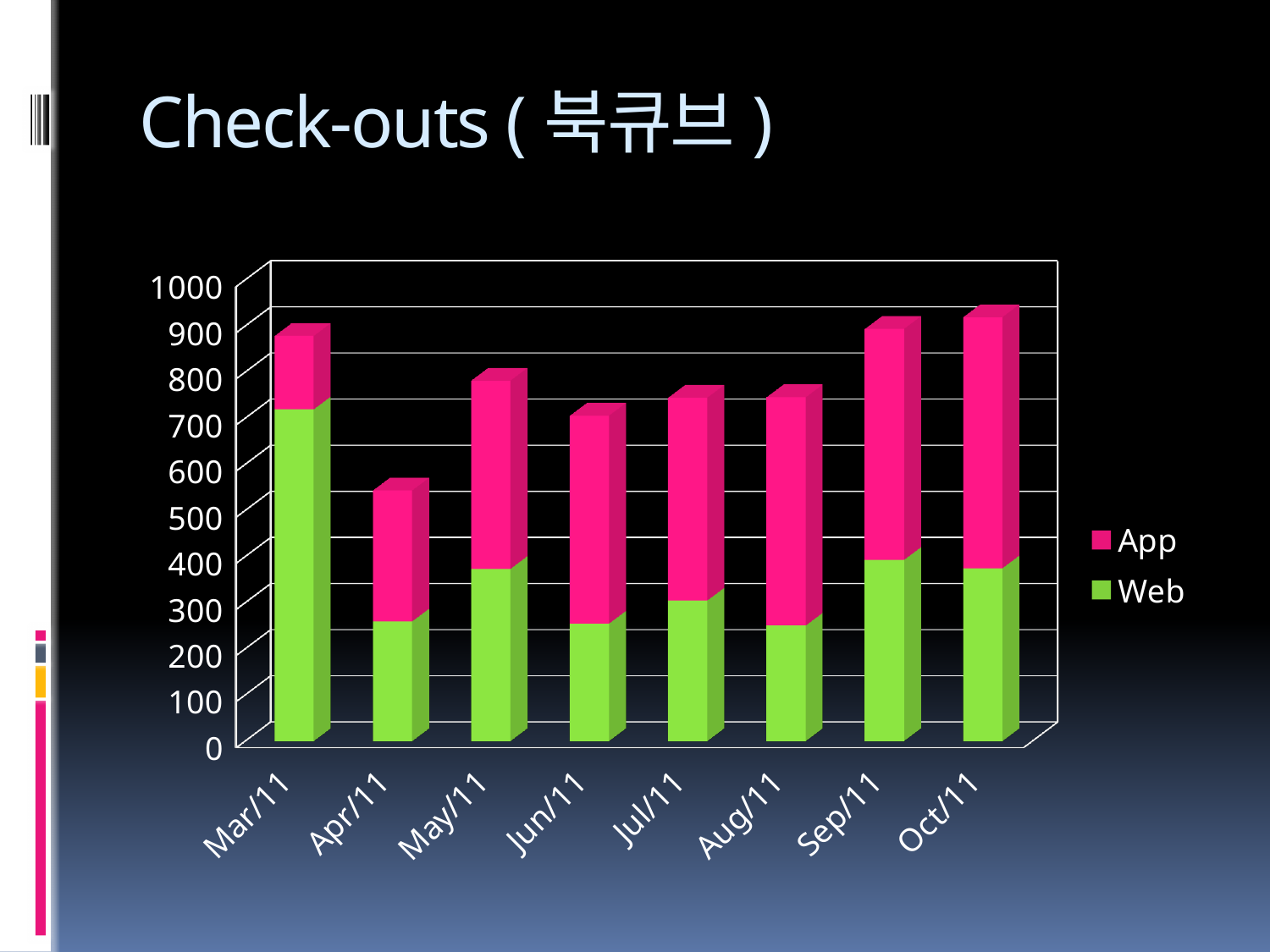
What kind of chart is shown on the slide? stacked bar chart Which series is shown in green in the chart? Web What is the title of the slide containing the chart? Check-outs ( 북큐브 ) Which is larger: the App value for Apr/11 or the App value for Sep/11? Sep/11 Which month has the highest Web check-outs in the chart? Mar/11 Is the total stacked value for Oct/11 greater or less than 800? greater Which month has the lowest total check-outs in the chart? Apr/11 Is the Web value for Mar/11 greater or less than 600? greater How many series does the chart's legend list? 2 Is the total stacked value for Apr/11 greater or less than 600? less Which is larger: the total check-outs for Mar/11 or for Apr/11? Mar/11 How many months are shown on the x axis of the chart? 8